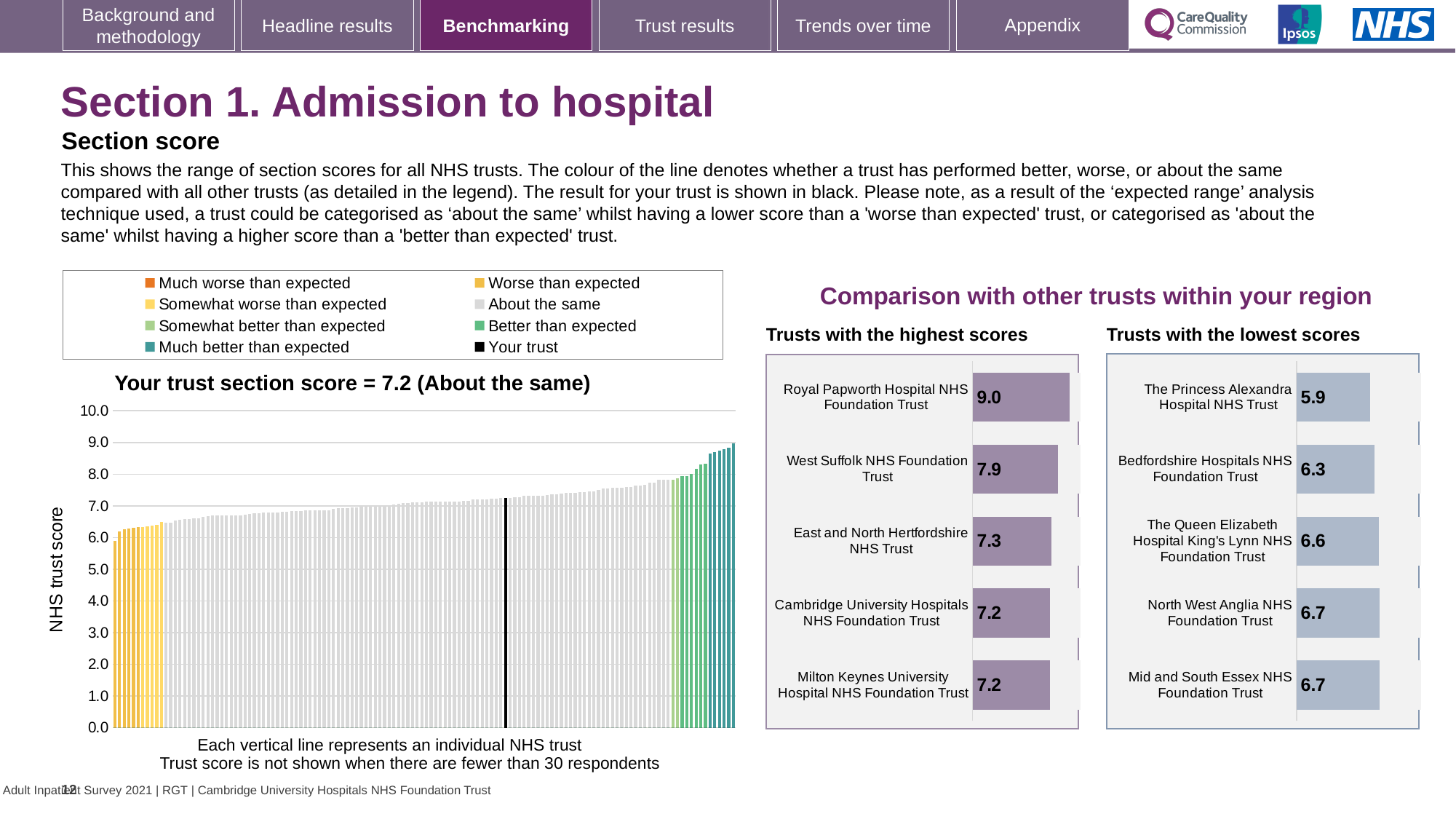
In the 'Trusts with the lowest scores' chart, which has the larger score: Bedfordshire Hospitals NHS Foundation Trust or North West Anglia NHS Foundation Trust? North West Anglia NHS Foundation Trust In the 'Trusts with the highest scores' chart, what is the score for Royal Papworth Hospital NHS Foundation Trust? 9.0 In the 'Trusts with the highest scores' chart, what is the score for West Suffolk NHS Foundation Trust? 7.9 What type of chart is the 'Trusts with the lowest scores' chart? Bar chart In the 'Trusts with the lowest scores' chart, what is the score for The Princess Alexandra Hospital NHS Trust? 5.9 In the 'Trusts with the highest scores' chart, which trust has the highest score? Royal Papworth Hospital NHS Foundation Trust In the 'Your trust section score' chart, what is the section score for your trust? 7.2 In the 'Trusts with the lowest scores' chart, which trust has the lowest score? The Princess Alexandra Hospital NHS Trust How many trusts are shown in the 'Trusts with the highest scores' chart? 5 In the 'Your trust section score' chart, what colour represents 'Your trust' according to the legend? Black In the 'Trusts with the lowest scores' chart, what is the score for Bedfordshire Hospitals NHS Foundation Trust? 6.3 In the 'Trusts with the highest scores' chart, what is the difference between the scores of Royal Papworth Hospital NHS Foundation Trust and West Suffolk NHS Foundation Trust? 1.1